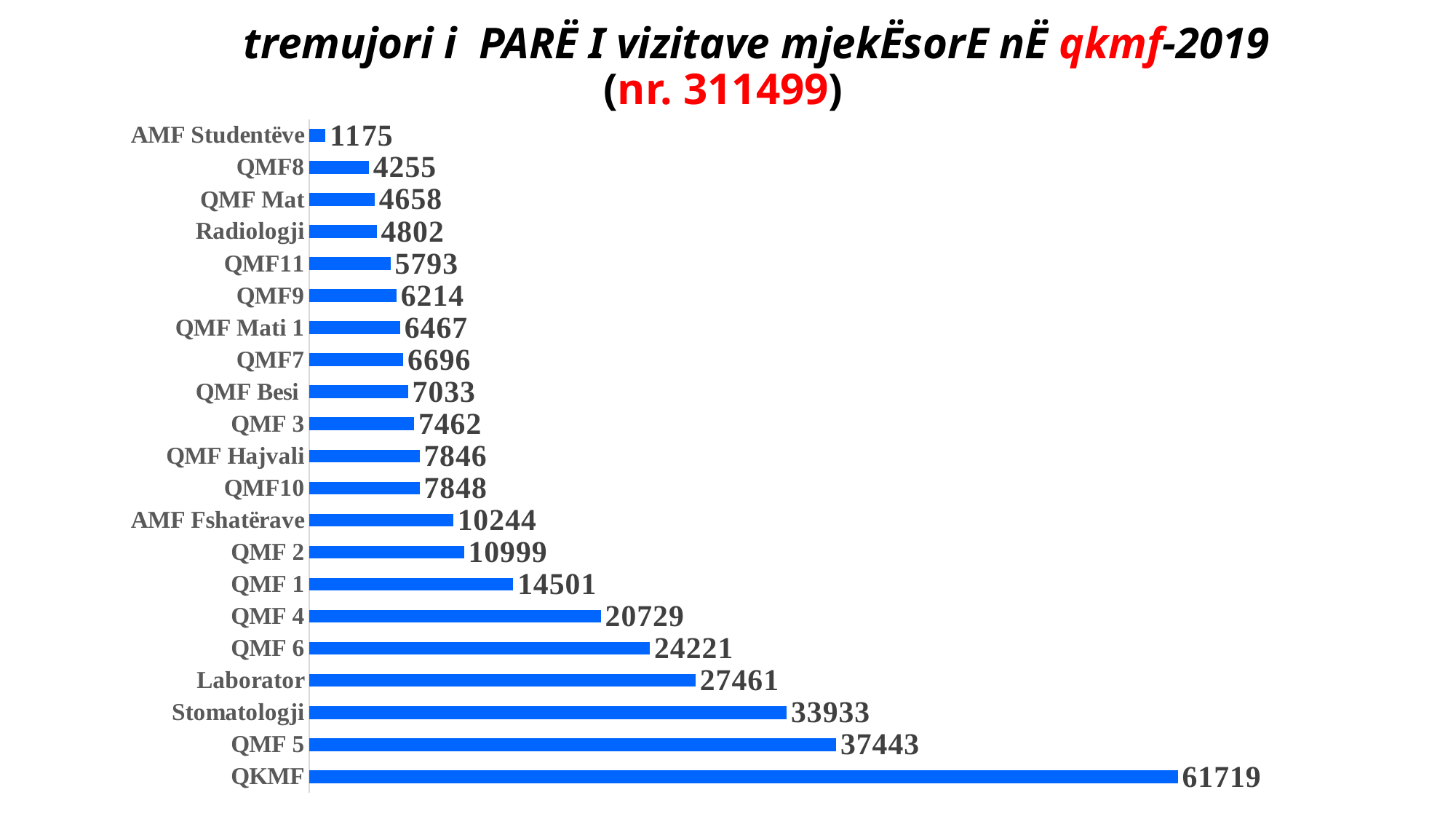
What total number is shown in red in the slide title? 311499 Which category has the lowest value? AMF Studentëve Which category has the highest value? QKMF What is the value for Radiologji? 4802 What is the value for AMF Fshatërave? 10244 How many categories are shown in the chart? 21 What is the value for QKMF? 61719 What is the difference between the values for QKMF and QMF 5? 24276 What is the value for Stomatologji? 33933 What kind of chart is shown on the slide? Bar chart What is the difference between the values for Stomatologji and Laborator? 6472 Which has a larger value, QMF 4 or QMF 6? QMF 6